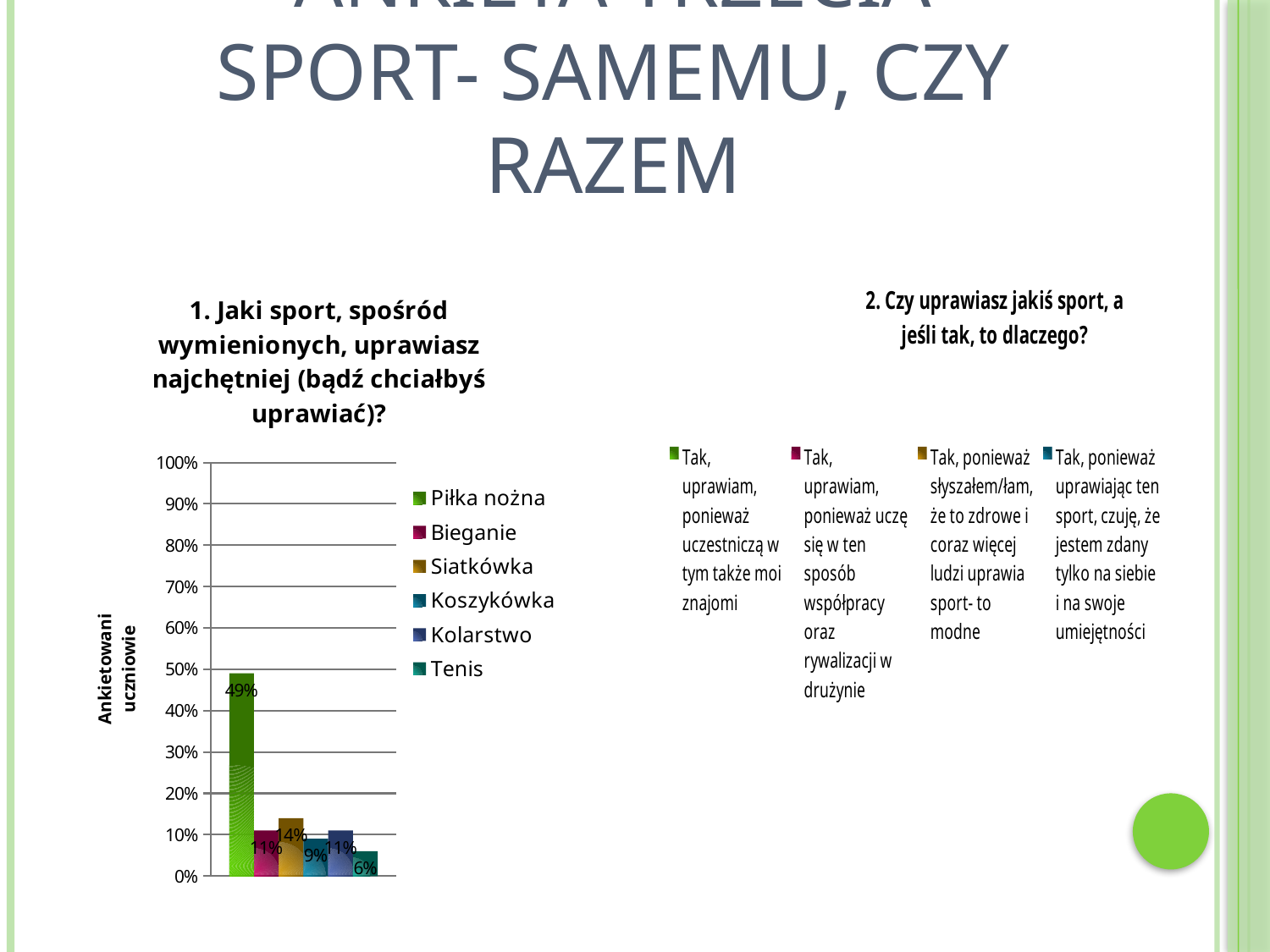
In the chart titled "1. Jaki sport, spośród wymienionych, uprawiasz najchętniej (bądź chciałbyś uprawiać)?", what is the value for Siatkówka? 14% In the chart titled "2. Czy uprawiasz jakiś sport, a jeśli tak, to dlaczego?", how many entries does the legend list? 4 In the chart titled "1. Jaki sport, spośród wymienionych, uprawiasz najchętniej (bądź chciałbyś uprawiać)?", which sport has the lowest value? Tenis In the chart titled "1. Jaki sport, spośród wymienionych, uprawiasz najchętniej (bądź chciałbyś uprawiać)?", what is the value for Tenis? 6% In the chart titled "1. Jaki sport, spośród wymienionych, uprawiasz najchętniej (bądź chciałbyś uprawiać)?", what is the label of the vertical axis? Ankietowani uczniowie In the chart titled "1. Jaki sport, spośród wymienionych, uprawiasz najchętniej (bądź chciałbyś uprawiać)?", which is larger, the value for Siatkówka or the value for Koszykówka? Siatkówka What kind of chart is the chart titled "1. Jaki sport, spośród wymienionych, uprawiasz najchętniej (bądź chciałbyś uprawiać)?"? Bar chart In the chart titled "1. Jaki sport, spośród wymienionych, uprawiasz najchętniej (bądź chciałbyś uprawiać)?", what is the value for Piłka nożna? 49% In the chart titled "1. Jaki sport, spośród wymienionych, uprawiasz najchętniej (bądź chciałbyś uprawiać)?", how many series does the legend list? 6 In the chart titled "1. Jaki sport, spośród wymienionych, uprawiasz najchętniej (bądź chciałbyś uprawiać)?", what is the value for Koszykówka? 9% In the chart titled "1. Jaki sport, spośród wymienionych, uprawiasz najchętniej (bądź chciałbyś uprawiać)?", which sport has the highest value? Piłka nożna In the chart titled "1. Jaki sport, spośród wymienionych, uprawiasz najchętniej (bądź chciałbyś uprawiać)?", what is the difference between the values for Piłka nożna and Siatkówka? 35%